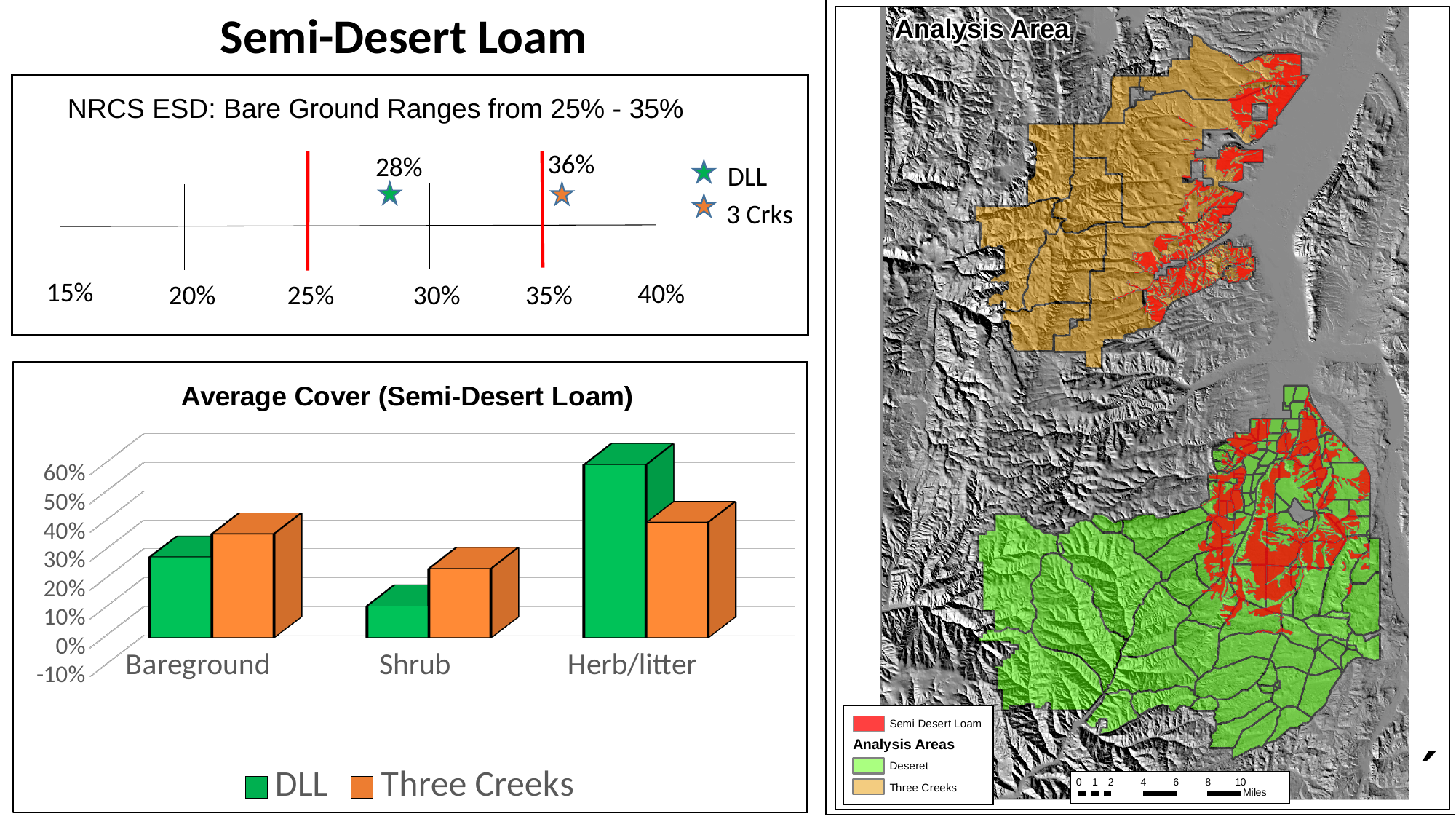
In the 'Average Cover (Semi-Desert Loam)' chart, what kind of chart is it? bar chart In the 'Average Cover (Semi-Desert Loam)' chart, is the DLL value for Herb/litter greater or less than 50%? greater In the NRCS ESD bare ground number line chart at the top left, what is the difference between the 3 Crks value and the DLL value? 8% In the 'Average Cover (Semi-Desert Loam)' chart, how many categories are shown on the x axis? 3 In the 'Average Cover (Semi-Desert Loam)' chart, for Shrub, which series is larger, DLL or Three Creeks? Three Creeks In the NRCS ESD bare ground number line chart at the top left, what is the bare ground value for DLL? 28% In the 'Average Cover (Semi-Desert Loam)' chart, which category has the lowest Three Creeks value? Shrub In the 'Average Cover (Semi-Desert Loam)' chart, is the DLL value for Shrub greater or less than 20%? less In the 'Average Cover (Semi-Desert Loam)' chart, which category has the highest DLL value? Herb/litter In the 'Average Cover (Semi-Desert Loam)' chart, how many series does the legend list? 2 In the 'Average Cover (Semi-Desert Loam)' chart, for Herb/litter, which series is larger, DLL or Three Creeks? DLL In the 'Average Cover (Semi-Desert Loam)' chart, which category has the lowest DLL value? Shrub